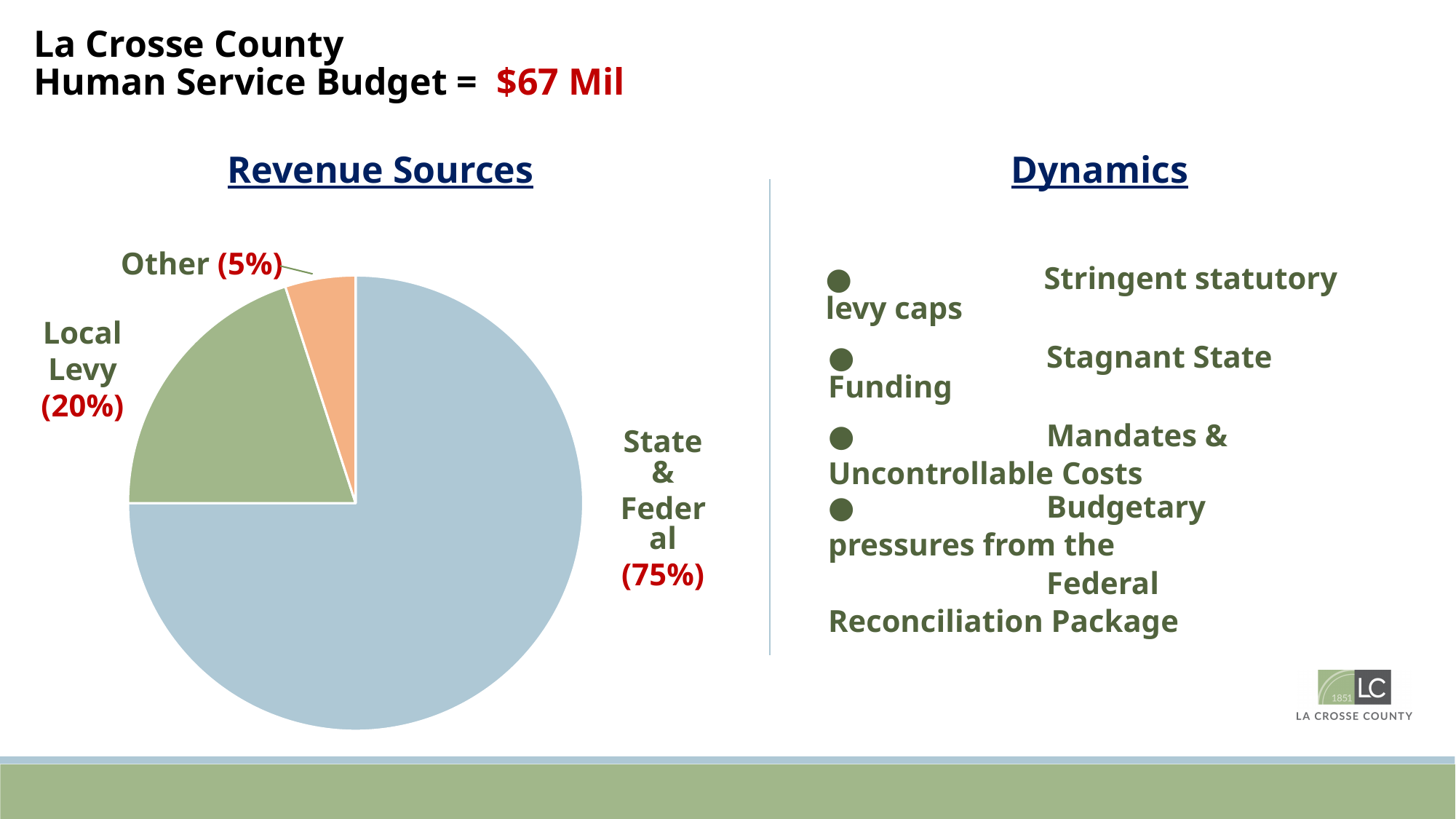
What is the difference in percentage points between the State & Federal slice and the Local Levy slice? 55 How many slices does the Revenue Sources pie chart have? 3 What is the difference in percentage points between the Local Levy slice and the Other slice? 15 What share of the pie does Local Levy represent? 20% What colour is the State & Federal slice of the pie? light blue What is the title of the pie chart? Revenue Sources Which revenue source has the largest slice of the pie? State & Federal What kind of chart is shown under "Revenue Sources"? pie chart Which is larger, the Local Levy slice or the Other slice? Local Levy What share of the pie does Other represent? 5% Which revenue source has the smallest slice of the pie? Other What share of the pie does State & Federal represent? 75%